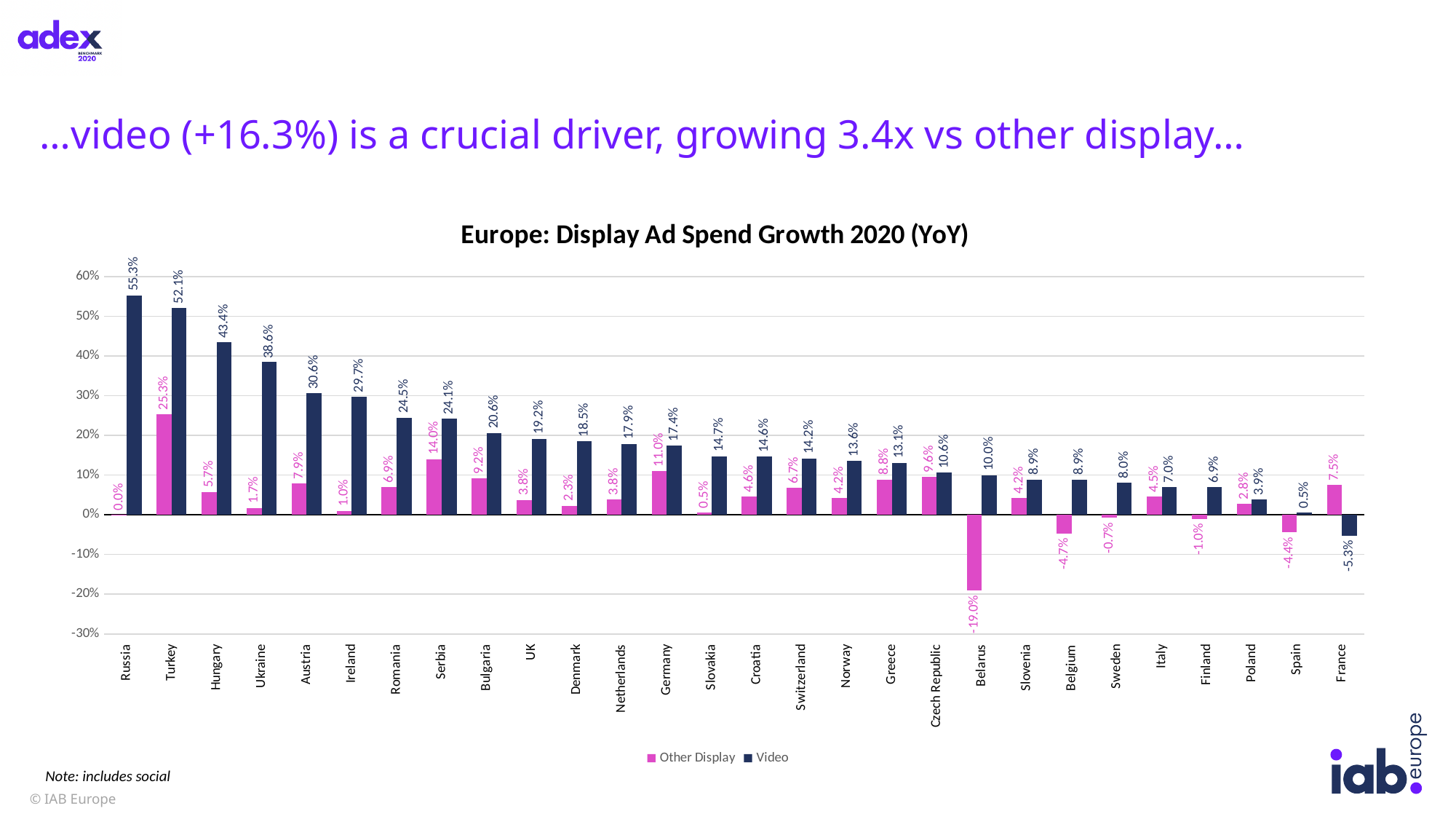
What kind of chart is shown on the slide? Bar chart What is the Video growth value for Russia? 55.3% What is the Other Display growth value for Turkey? 25.3% For France, which is larger: the Other Display value or the Video value? Other Display What is the Other Display growth value for Belarus? -19.0% Which country has the lowest Other Display growth? Belarus What is the difference between the Video and Other Display growth values for Turkey? 26.8% Which country has the lowest Video growth? France What is the title of the chart? Europe: Display Ad Spend Growth 2020 (YoY) How many series does the legend list? 2 Which country has the highest Video growth? Russia How many countries are shown on the chart? 28